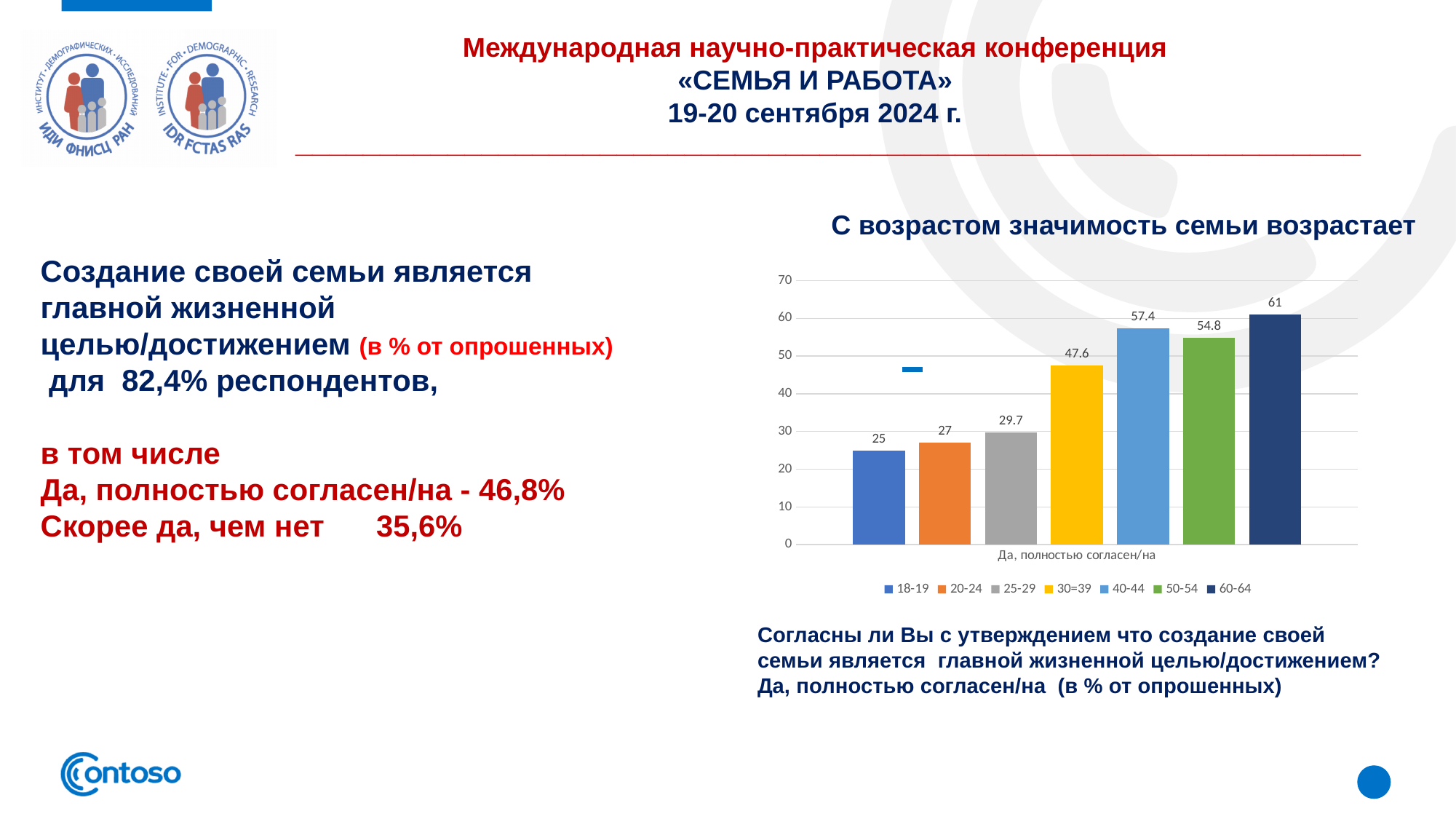
What is the value for the 60-64 age group? 61 What kind of chart is shown? bar chart Do the values generally rise or fall from the youngest to the oldest age group? rise What is the value for the 30=39 age group? 47.6 What is the value for the 18-19 age group? 25 Which age group has the highest value? 60-64 What is the title of the chart? С возрастом значимость семьи возрастает Is the value for 40-44 greater or less than 50? greater What is the difference between the values for 40-44 and 50-54? 2.6 How many age groups does the legend list? 7 Which age group has the lowest value? 18-19 Which is larger, the value for 25-29 or the value for 20-24? 25-29